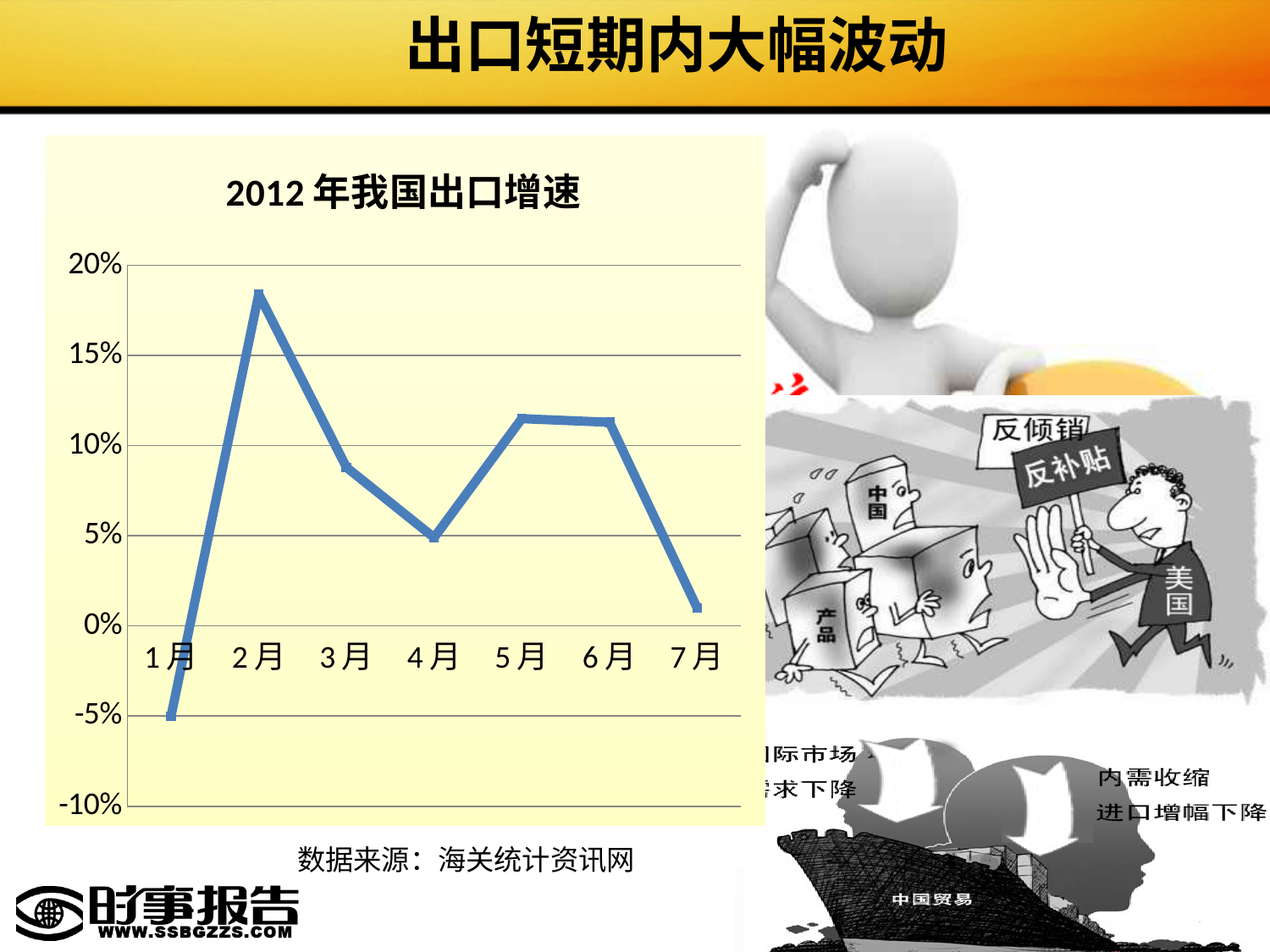
How many months are plotted on the x axis of the chart? 7 Is the value for 5月 greater or less than 10%? greater Is the value for 7月 greater or less than 5%? less What is the lowest tick shown on the y axis of the chart? -10% Which is larger, the value for 2月 or the value for 3月? 2月 What kind of chart is shown on the slide? line chart Which month has the lowest export growth rate in the chart? 1月 Does the export growth rate rise or fall from 6月 to 7月? fall Is the value for 2月 greater or less than 15%? greater What is the title of the chart? 2012 年我国出口增速 Which month has the highest export growth rate in the chart? 2月